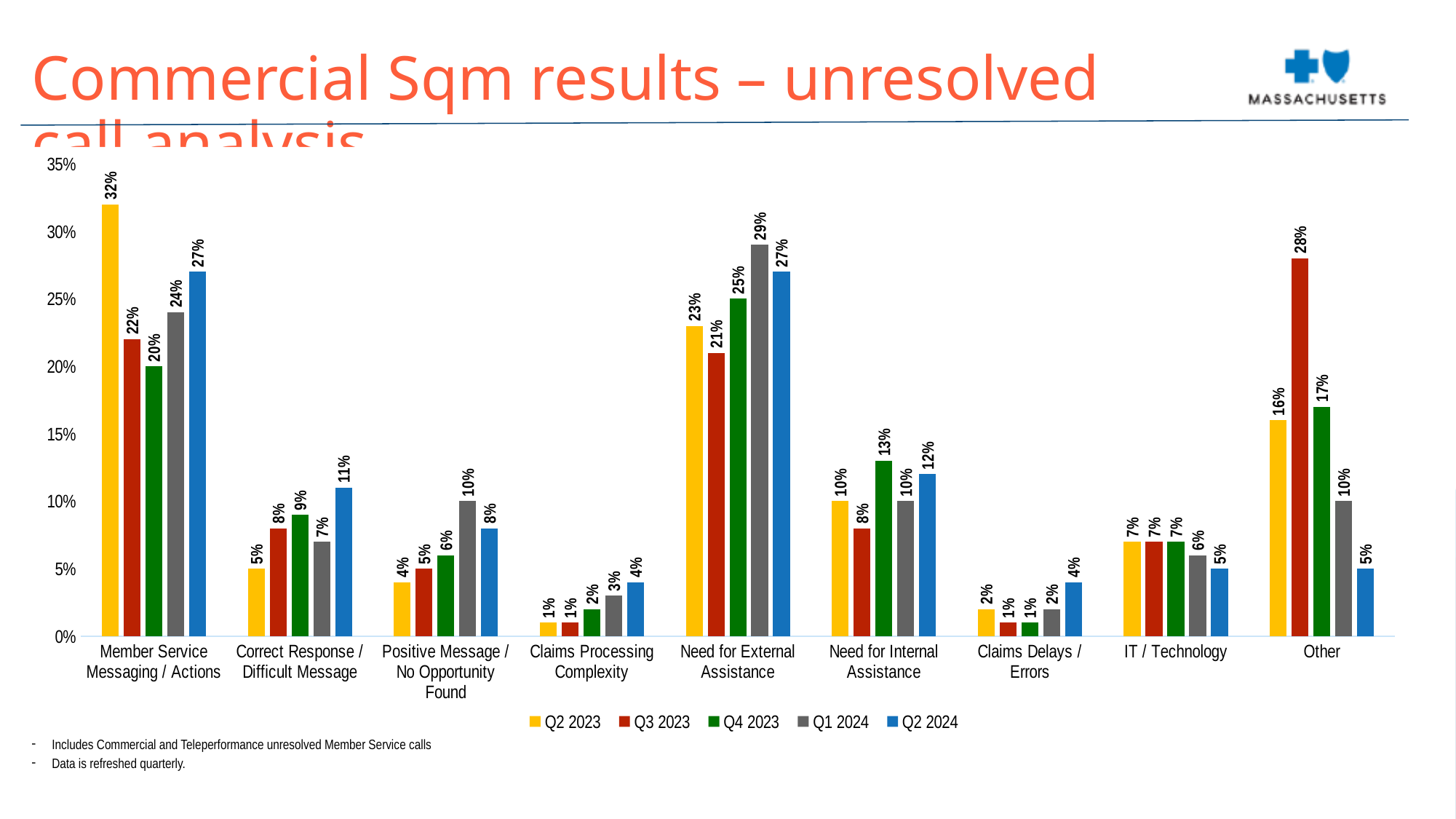
What is the difference between the Q2 2023 and Q2 2024 values for Member Service Messaging / Actions? 5% What is the Q1 2024 value for Need for External Assistance? 29% Which category has the highest Q2 2023 value? Member Service Messaging / Actions What is the Q2 2024 value for Member Service Messaging / Actions? 27% How many categories are shown on the x axis? 9 How many series does the legend list? 5 Which is larger for Need for Internal Assistance: the Q4 2023 value or the Q2 2024 value? Q4 2023 What is the Q3 2023 value for Other? 28% Do the values for Claims Processing Complexity rise or fall from Q2 2023 to Q2 2024? Rise Which series is shown in blue in the legend? Q2 2024 What kind of chart is shown on the slide? Bar chart